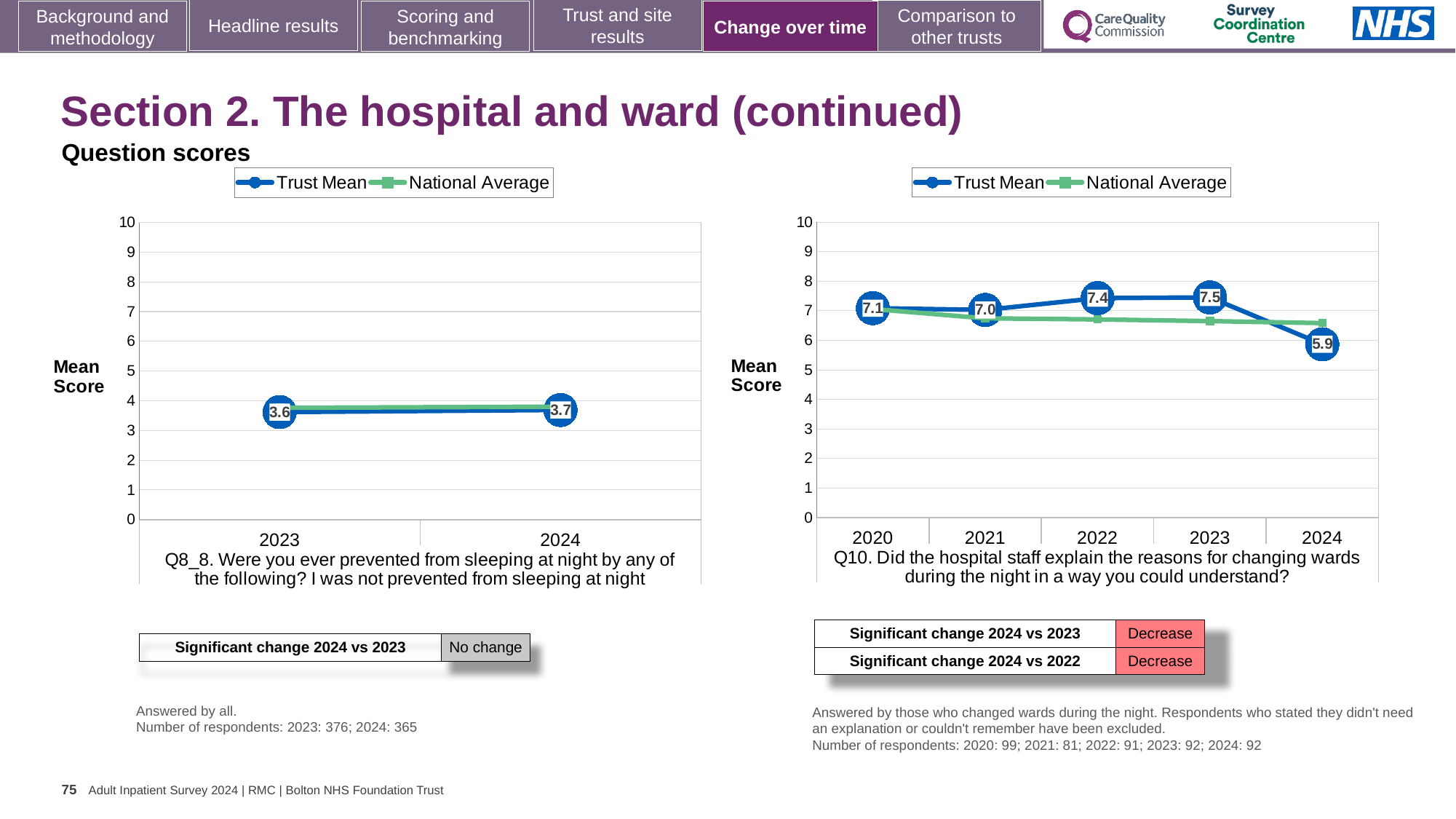
In the right chart (Q10), which year has the highest Trust Mean score? 2023 In the left chart (Q8_8), what is the Trust Mean score for 2023? 3.6 In the right chart (Q10), which year has the lowest Trust Mean score? 2024 In the right chart (Q10), what is the Trust Mean score for 2024? 5.9 In the right chart (Q10), what is the Trust Mean score for 2022? 7.4 How many years are plotted on the x axis of the right chart (Q10)? 5 What kind of chart is the left chart (Q8_8)? Line chart In the right chart (Q10), what is the difference between the Trust Mean scores for 2023 and 2024? 1.6 In the right chart (Q10), is the Trust Mean score for 2020 or 2022 larger? 2022 How many series does the legend of the left chart (Q8_8) list? 2 In the right chart (Q10), is the National Average value for 2024 greater or less than 5? greater In the left chart (Q8_8), what is the Trust Mean score for 2024? 3.7